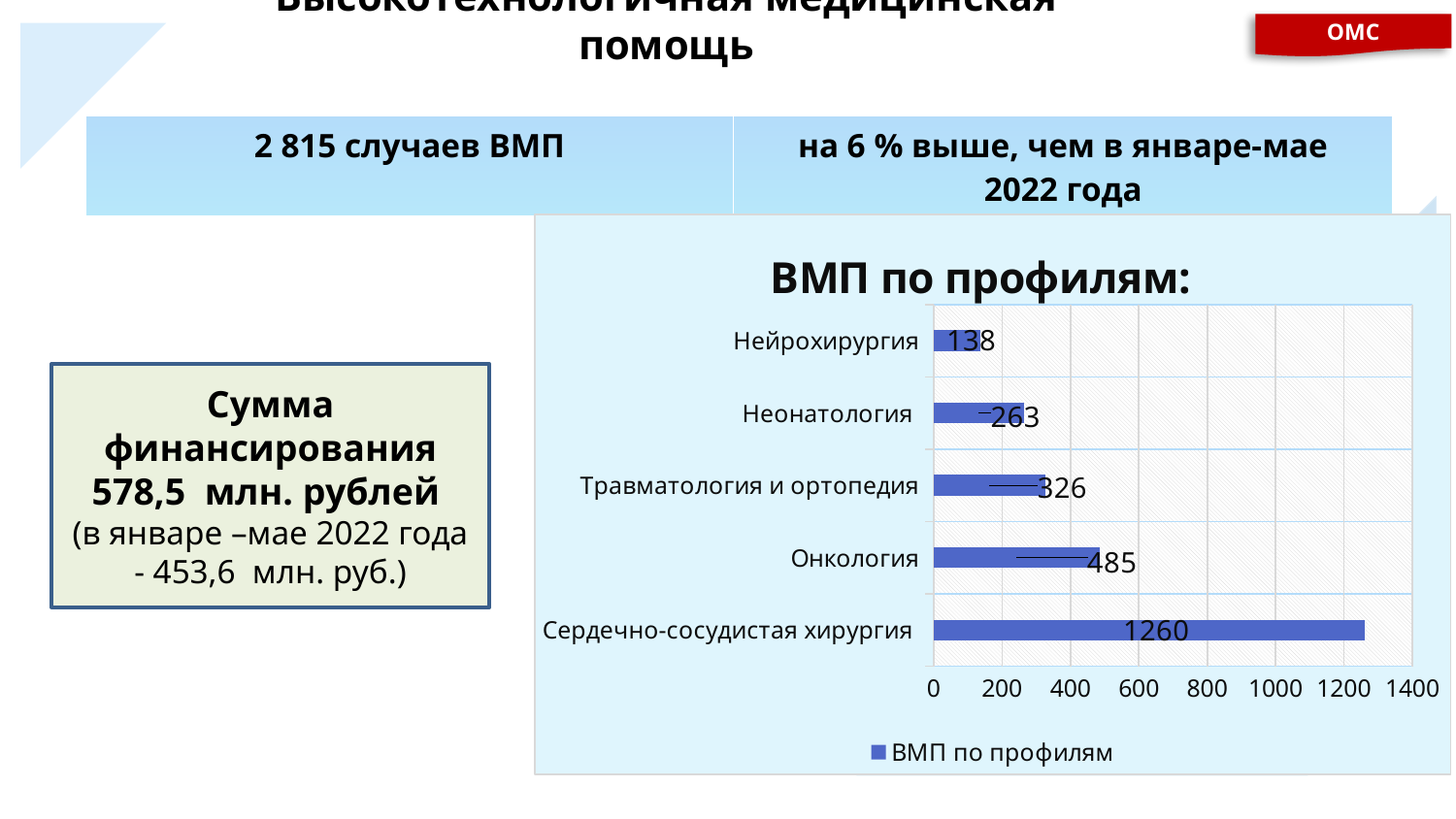
What kind of chart is used to show ВМП по профилям? bar chart What is the value for Онкология in the ВМП по профилям chart? 485 What is the value for Сердечно-сосудистая хирургия in the ВМП по профилям chart? 1260 What is the difference between the values for Онкология and Травматология и ортопедия? 159 What is the value for Нейрохирургия in the ВМП по профилям chart? 138 How many categories are shown in the ВМП по профилям chart? 5 What is the value for Неонатология in the ВМП по профилям chart? 263 What is the title of the chart on the slide? ВМП по профилям: Is the value for Онкология greater or less than 400? greater Which is larger, the value for Неонатология or the value for Травматология и ортопедия? Травматология и ортопедия Which category has the highest value in the ВМП по профилям chart? Сердечно-сосудистая хирургия Which category has the lowest value in the ВМП по профилям chart? Нейрохирургия